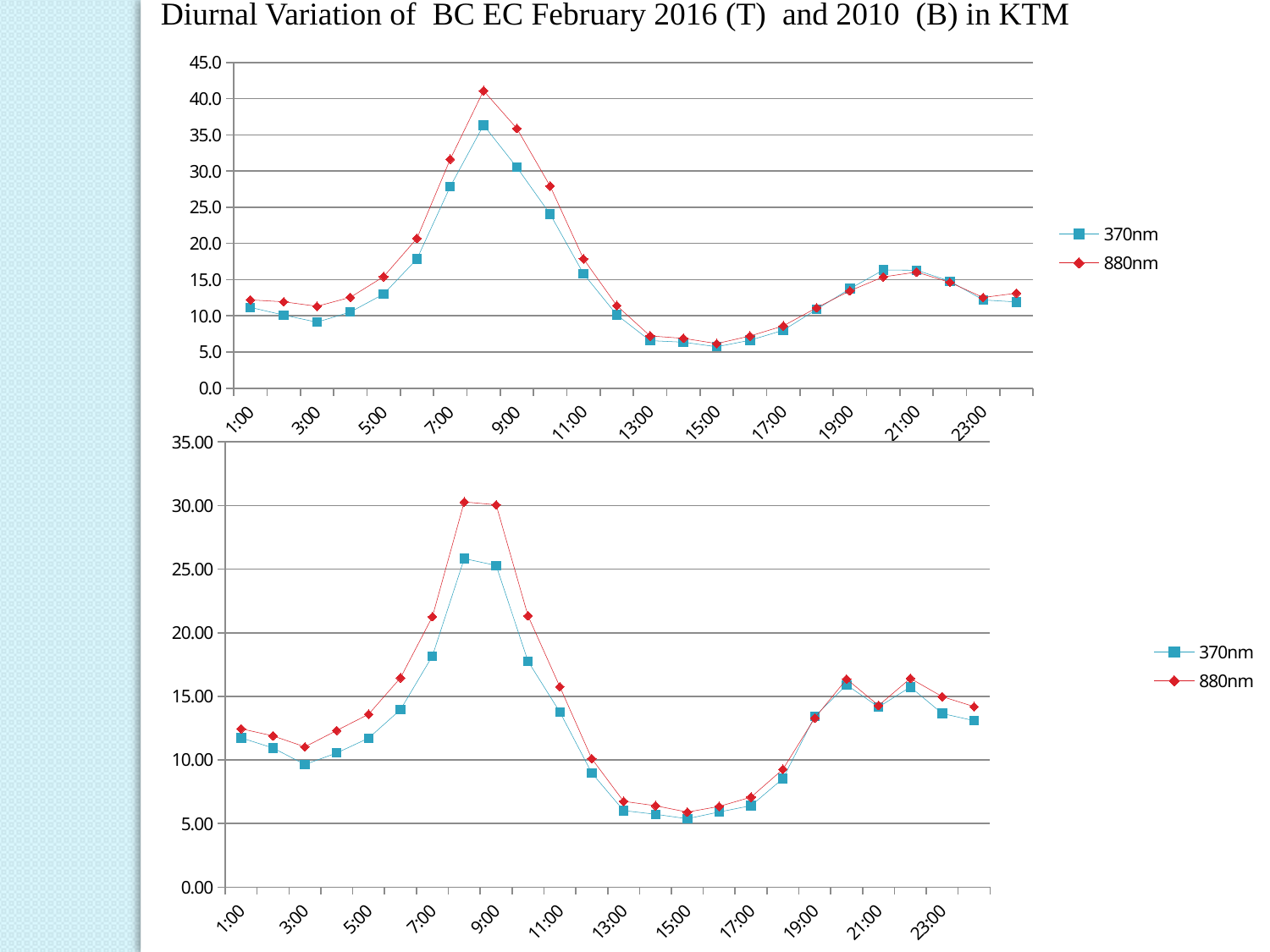
In the top chart (2016), which series is higher at 7:00, 370nm or 880nm? 880nm In the bottom chart (2010), is the 370nm value at 7:00 greater or less than 20.00? less In the bottom chart (2010), is the 880nm value at 7:00 greater or less than 20.00? greater In the top chart (2016), is the 880nm value at 7:00 greater or less than 30.0? greater What kind of chart is the top chart (2016)? line chart In the top chart (2016), at which labeled time does the 370nm series reach its lowest value? 15:00 In the top chart (2016), do the 880nm values rise or fall from 9:00 to 15:00? fall How many series does the legend of the bottom chart (2010) list? 2 What colour is the 880nm series in the bottom chart (2010)? red In the bottom chart (2010), which series reaches the higher peak, 370nm or 880nm? 880nm